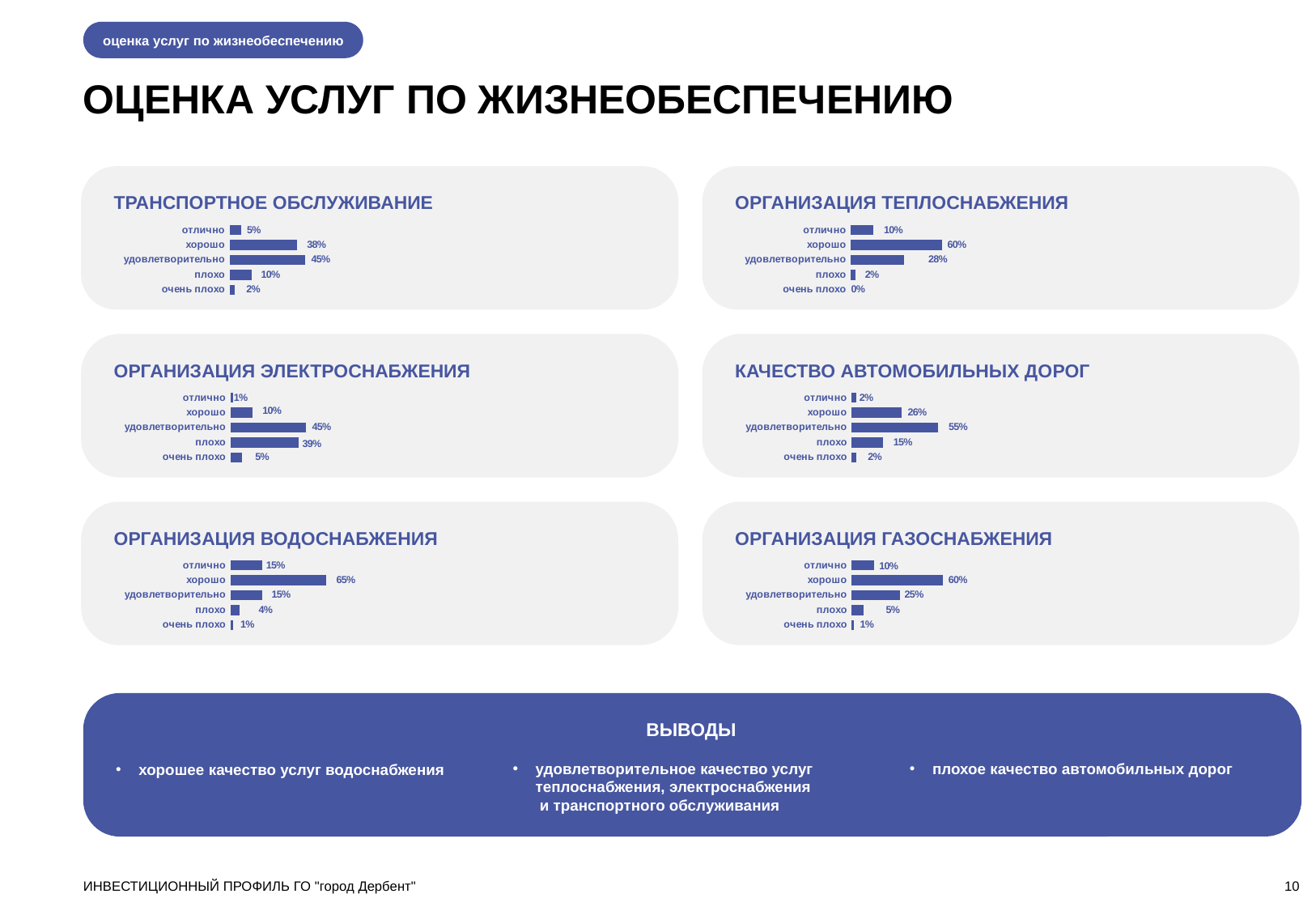
In the chart 'ОРГАНИЗАЦИЯ ЭЛЕКТРОСНАБЖЕНИЯ', what is the difference between 'удовлетворительно' and 'плохо'? 6% In the chart 'ОРГАНИЗАЦИЯ ЭЛЕКТРОСНАБЖЕНИЯ', which category has the lowest value? отлично In the chart 'ОРГАНИЗАЦИЯ ГАЗОСНАБЖЕНИЯ', what is the difference between 'хорошо' and 'удовлетворительно'? 35% What type of chart is used in 'ОРГАНИЗАЦИЯ ВОДОСНАБЖЕНИЯ'? bar chart In the chart 'ТРАНСПОРТНОЕ ОБСЛУЖИВАНИЕ', what is the value for 'удовлетворительно'? 45% In the chart 'КАЧЕСТВО АВТОМОБИЛЬНЫХ ДОРОГ', which is larger: 'плохо' or 'хорошо'? хорошо In the chart 'КАЧЕСТВО АВТОМОБИЛЬНЫХ ДОРОГ', what is the value for 'хорошо'? 26% How many charts are shown on the slide? 6 In the chart 'ОРГАНИЗАЦИЯ ТЕПЛОСНАБЖЕНИЯ', which category has the highest value? хорошо In the chart 'ОРГАНИЗАЦИЯ ВОДОСНАБЖЕНИЯ', what is the value for 'хорошо'? 65% In the chart 'ОРГАНИЗАЦИЯ ТЕПЛОСНАБЖЕНИЯ', what is the value for 'очень плохо'? 0% How many categories does the chart 'ОРГАНИЗАЦИЯ ГАЗОСНАБЖЕНИЯ' show? 5